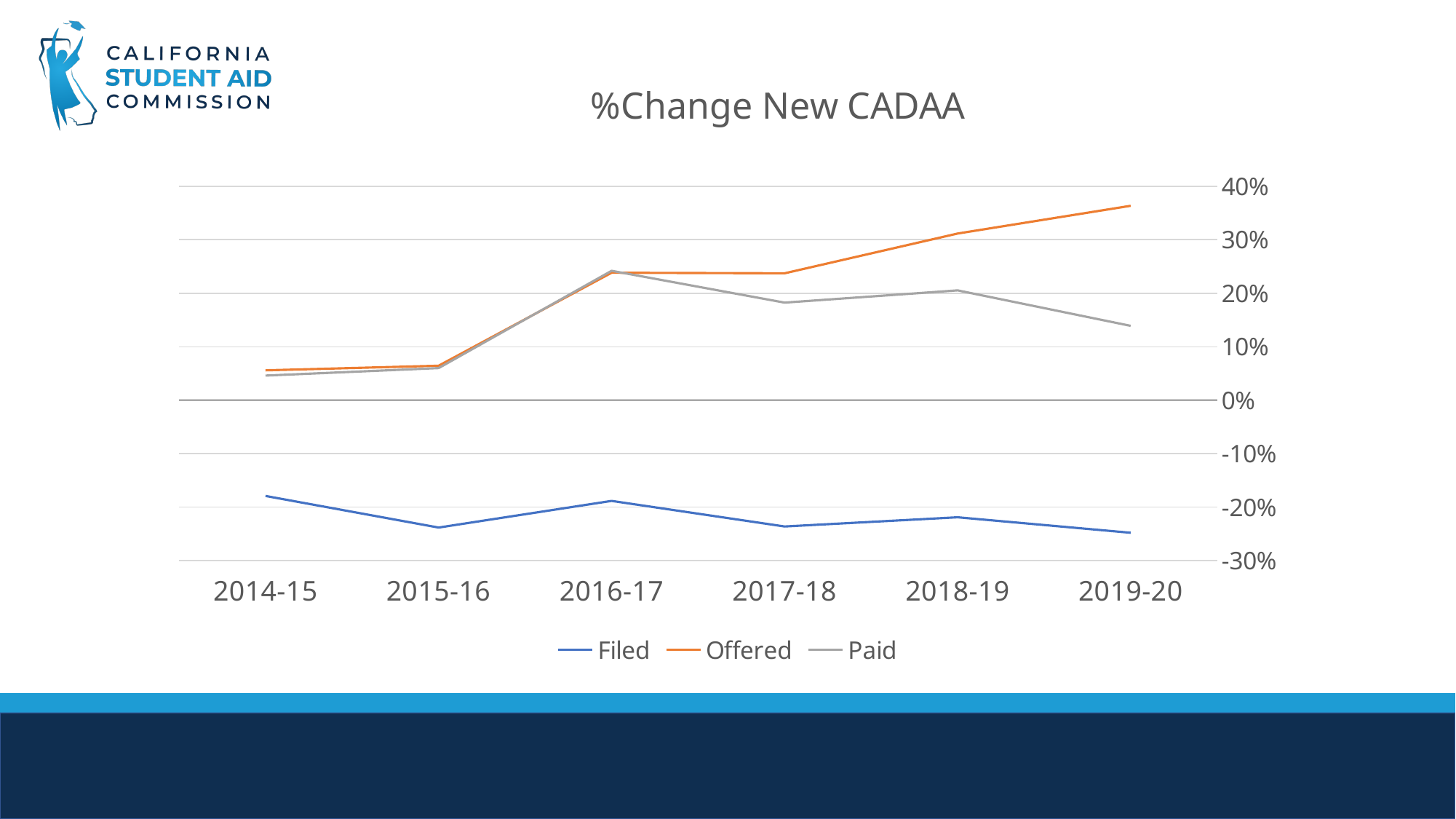
Is the value for Filed in 2019-20 greater or less than -20%? less What kind of chart is shown on the slide? line chart Is the value for Paid in 2019-20 greater or less than 10%? greater In 2019-20, which is larger, Offered or Paid? Offered How many academic years are shown on the x axis? 6 How many series does the legend list? 3 Does the Offered series rise or fall from 2016-17 to 2019-20? rise What is the title of the chart? %Change New CADAA Which series is drawn in orange? Offered Is the value for Offered in 2016-17 greater or less than 20%? greater In which year is the Offered series at its highest? 2019-20